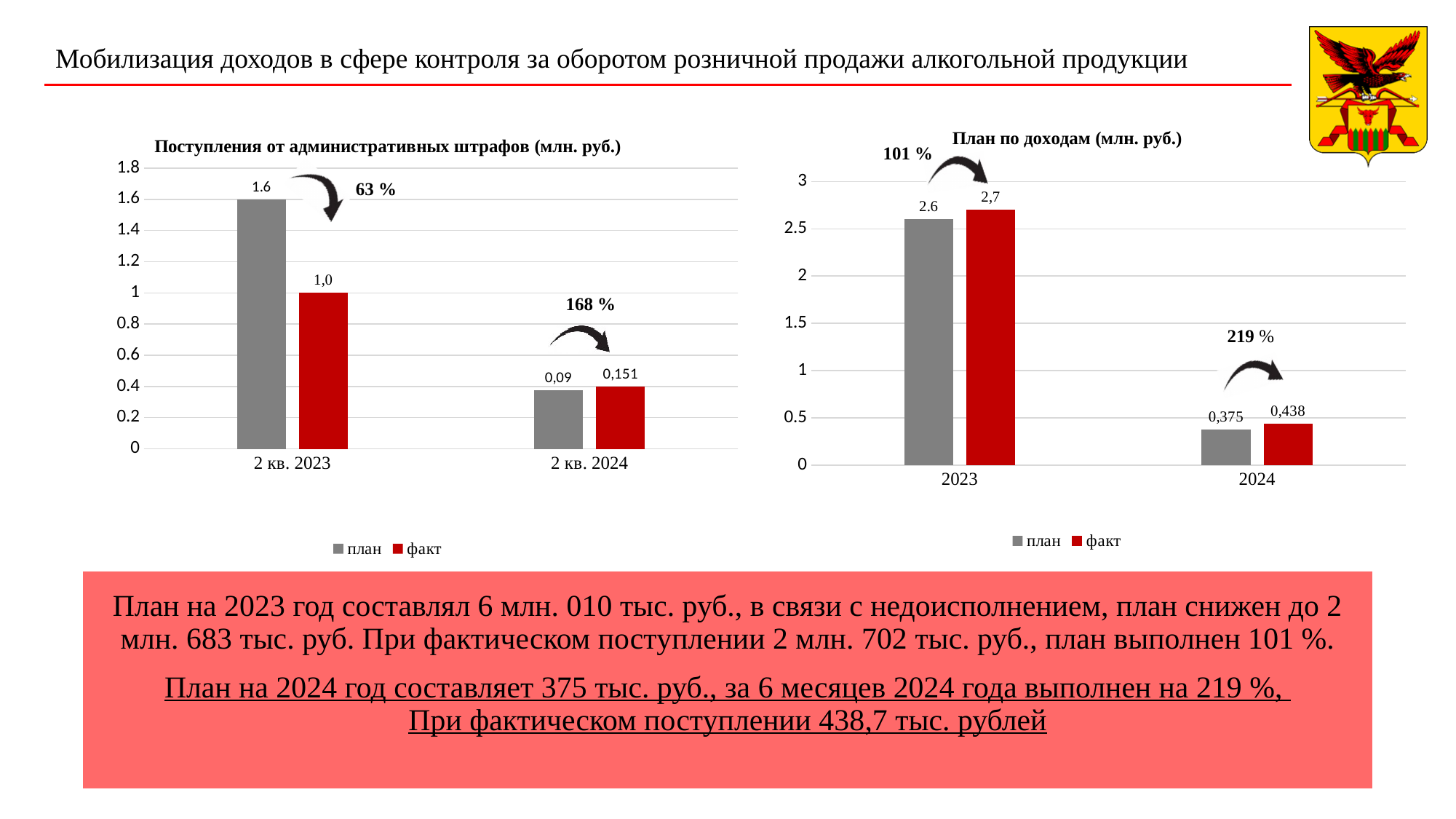
In the chart 'Поступления от административных штрафов (млн. руб.)', what is the value of план for 2 кв. 2023? 1.6 In the chart 'План по доходам (млн. руб.)', what is the value of план for 2023? 2.6 What type of chart is 'План по доходам (млн. руб.)'? bar chart In the chart 'Поступления от административных штрафов (млн. руб.)', what is the difference between план and факт for 2 кв. 2023? 0.6 In the chart 'План по доходам (млн. руб.)', how many categories are shown on the x axis? 2 In the chart 'Поступления от административных штрафов (млн. руб.)', how many series does the legend list? 2 In the chart 'Поступления от административных штрафов (млн. руб.)', what is the value of факт for 2 кв. 2023? 1,0 In the chart 'План по доходам (млн. руб.)', is the value of план for 2024 greater or less than 0.5? less In the chart 'План по доходам (млн. руб.)', which is larger for 2023: план or факт? факт In the chart 'Поступления от административных штрафов (млн. руб.)', what is the value of факт for 2 кв. 2024? 0,151 In the chart 'План по доходам (млн. руб.)', what is the value of факт for 2024? 0,438 In the chart 'Поступления от административных штрафов (млн. руб.)', which category has the highest план value? 2 кв. 2023